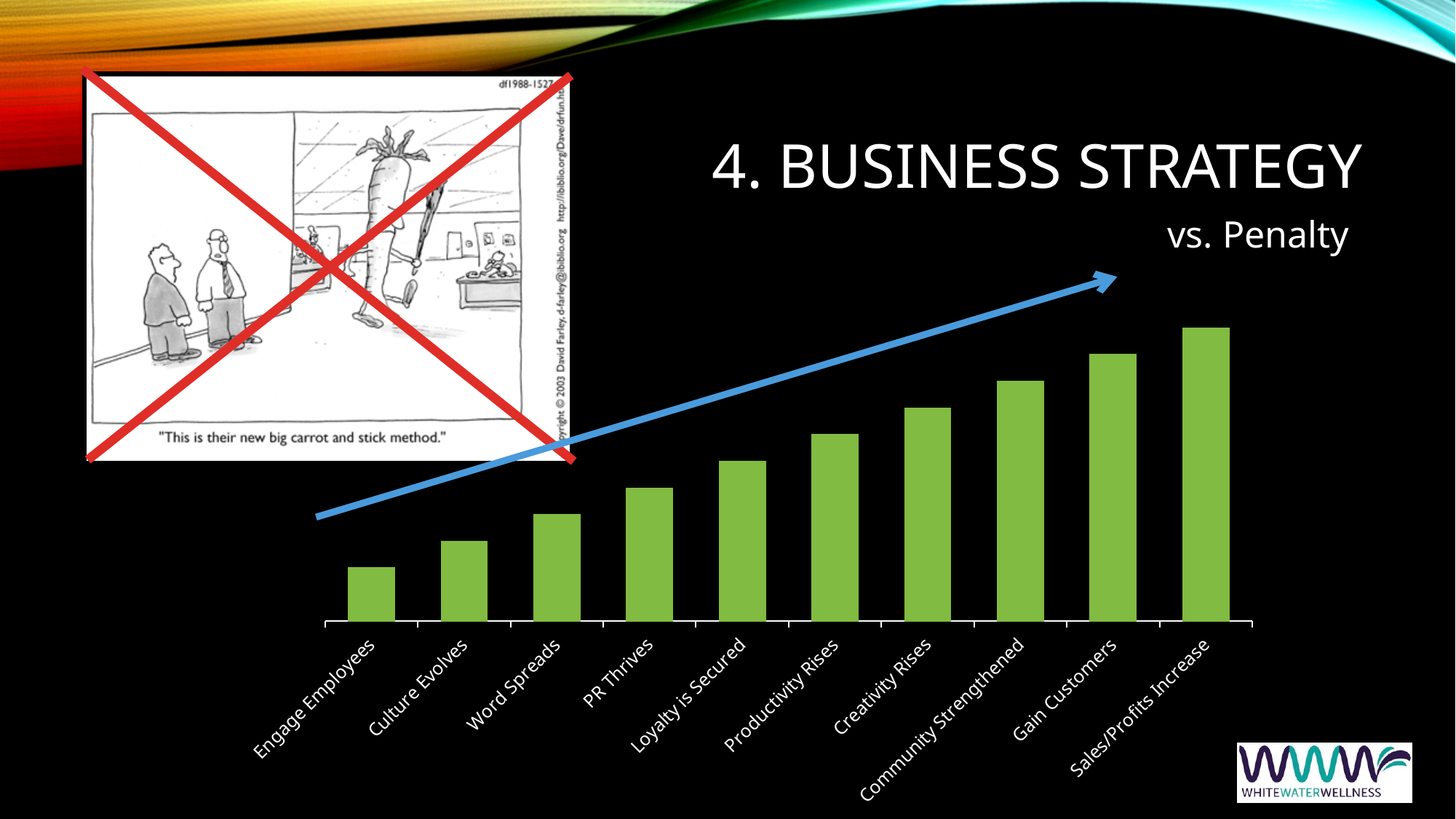
Which category has the tallest bar? Sales/Profits Increase What is the label of the first category on the left of the x axis? Engage Employees Which bar is taller, Word Spreads or Creativity Rises? Creativity Rises What colour are the bars in the chart? Green How many categories are plotted on the bar chart? 10 What kind of chart is shown on the slide? Bar chart Do the bar heights rise or fall from left to right along the x axis? Rise Which bar is shorter, PR Thrives or Community Strengthened? PR Thrives Which bar is taller, Gain Customers or Culture Evolves? Gain Customers Which category has the shortest bar? Engage Employees